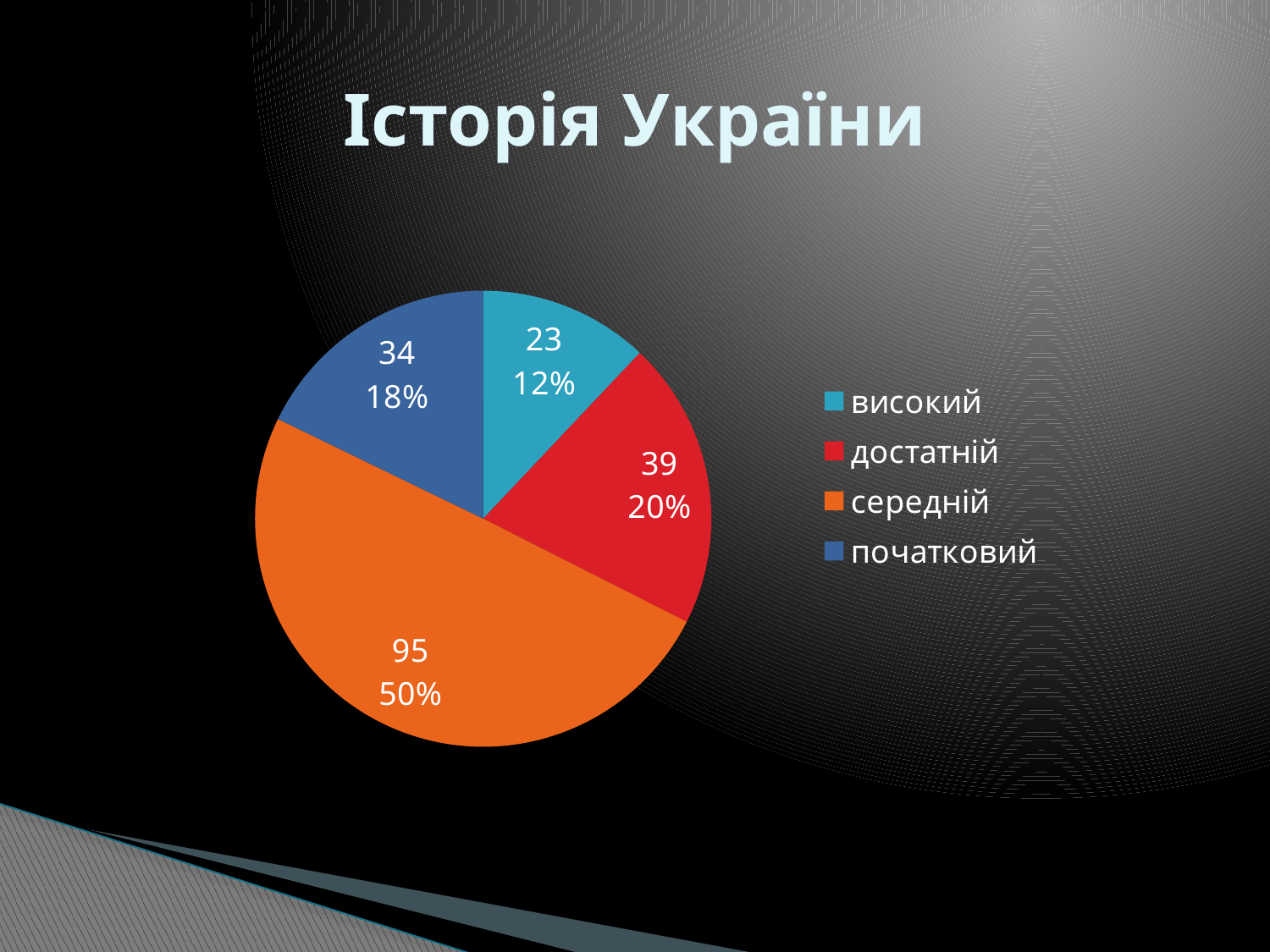
What percentage share does the "початковий" slice have? 18% What is the value for the "середній" slice? 95 Which is larger, the value for "достатній" or the value for "початковий"? достатній Which category has the smallest slice? високий What type of chart is shown on the slide? pie chart What is the difference between the values for "середній" and "достатній"? 56 Which category has the largest slice? середній What is the total of all the slice values? 191 What is the title of the slide? Історія України What percentage share does the "високий" slice have? 12% How many slices does the pie chart have? 4 What is the value for the "достатній" slice? 39